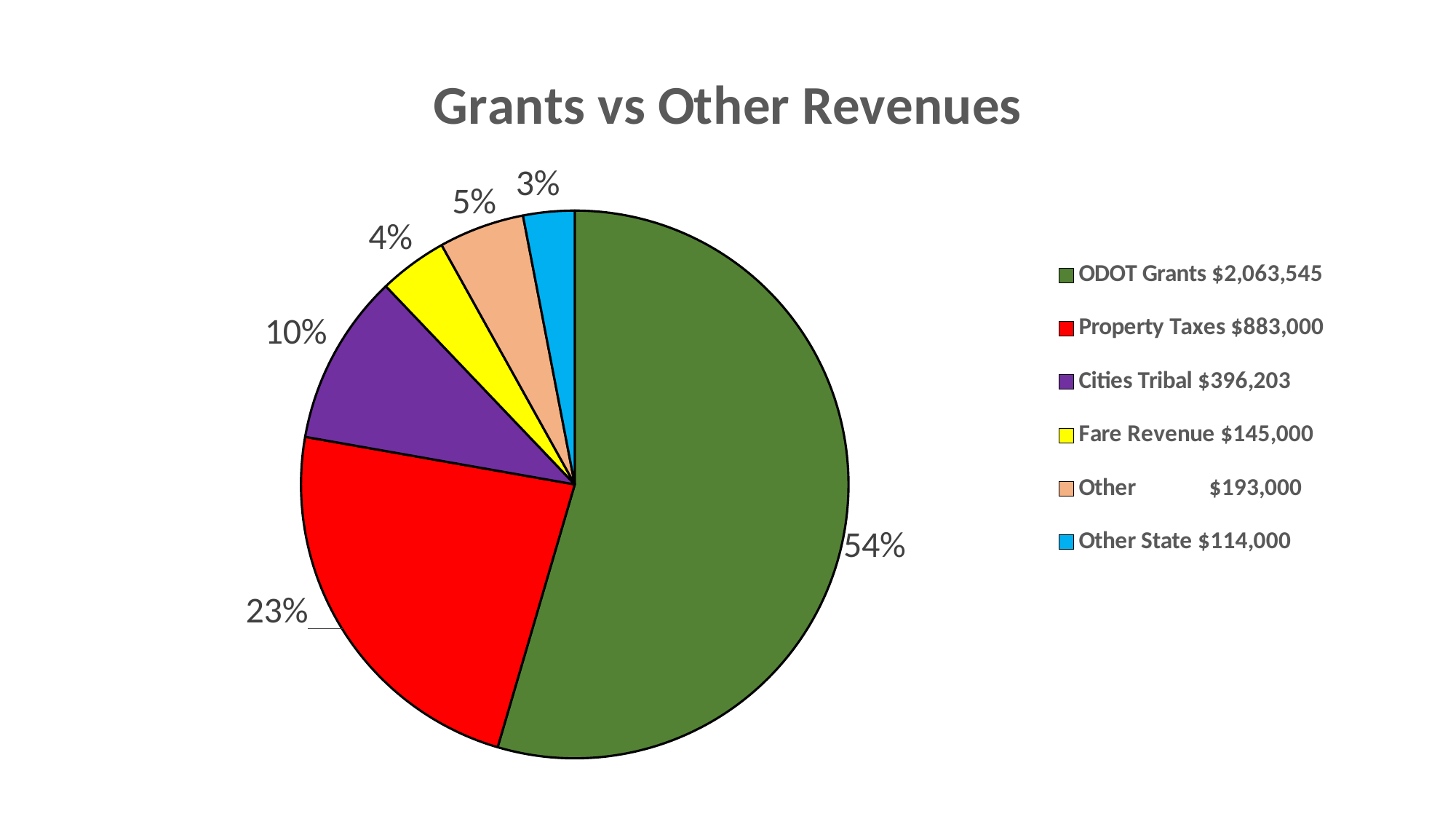
Which is larger, the Fare Revenue slice or the Other slice? Other What share of the pie does Cities Tribal represent? 10% How many slices does the pie chart have? 6 Which category has the largest slice of the pie? ODOT Grants What share of the pie does ODOT Grants represent? 54% What share of the pie does Other State represent? 3% Which category has the smallest slice of the pie? Other State What dollar value does the legend show for Other? $193,000 What type of chart is shown on the slide? Pie chart What is the title of the chart? Grants vs Other Revenues What dollar value does the legend show for Fare Revenue? $145,000